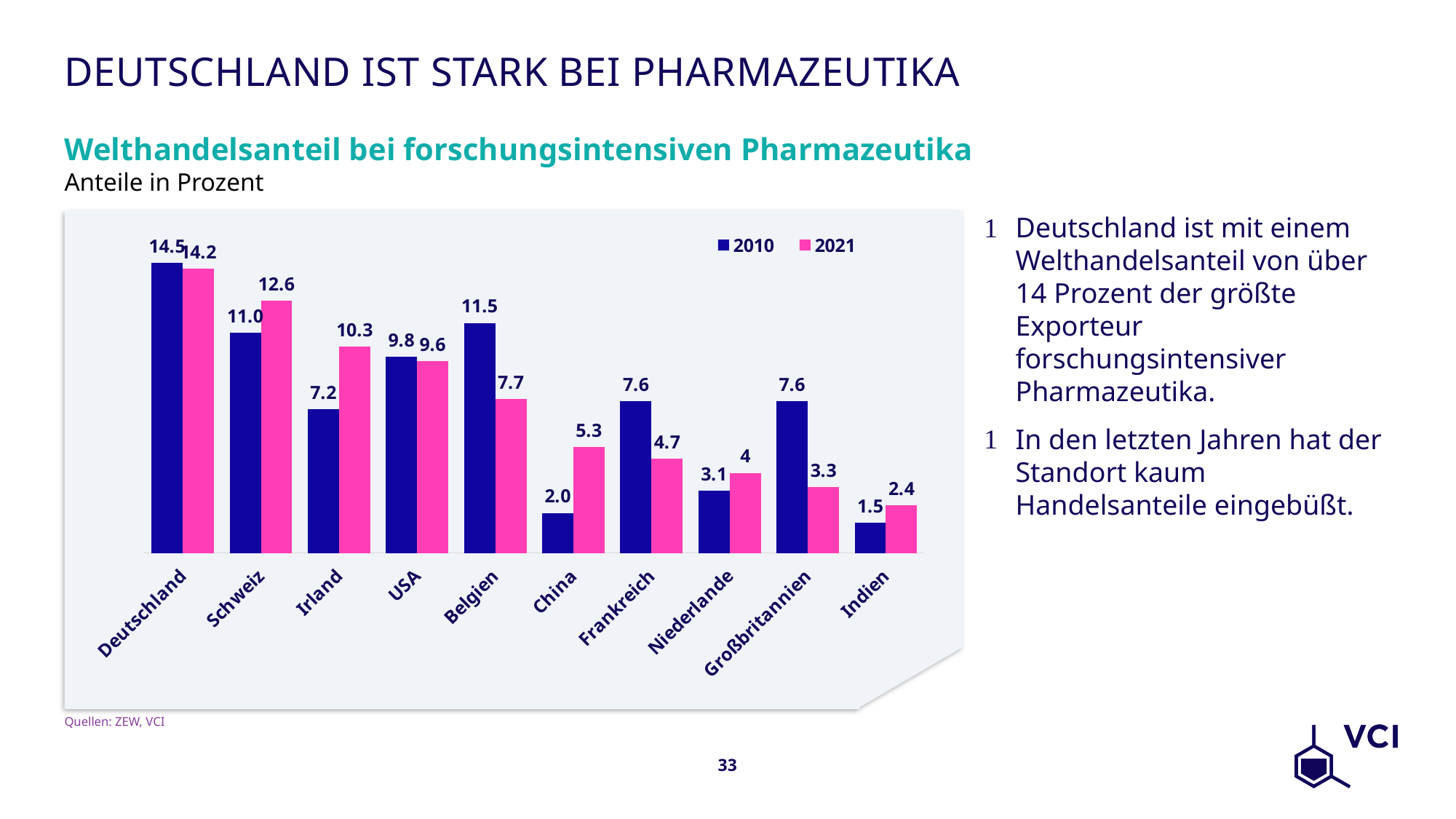
Which country has the lowest value in 2021? Indien Which country has the highest value in 2010? Deutschland What is the difference between the 2010 and 2021 values for Großbritannien? 4.3 What is the value for Niederlande in 2021? 4 How many countries are shown on the x axis? 10 What is the value for Schweiz in 2010? 11.0 How many series does the legend list? 2 Which colour represents the 2021 series? pink Which is larger for Belgien: the 2010 value or the 2021 value? 2010 What kind of chart is shown? bar chart What is the value for Irland in 2021? 10.3 What is the value for Deutschland in 2021? 14.2